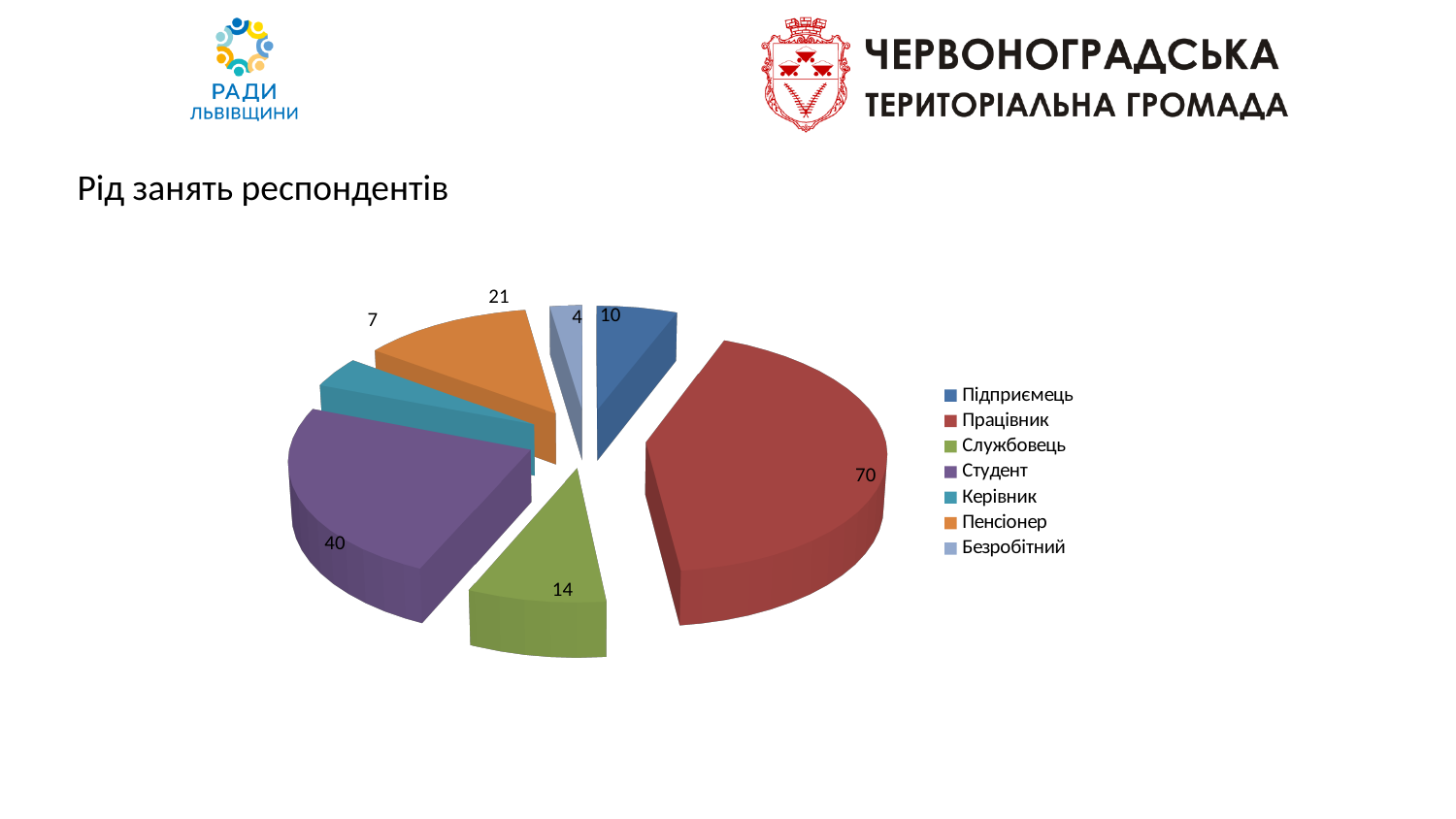
Which is larger, the value for Службовець or the value for Підприємець? Службовець What type of chart is shown on the slide? pie chart What is the value for Студент? 40 What colour is the slice for Пенсіонер? orange What is the value for Працівник? 70 What is the value for Пенсіонер? 21 What is the value for Керівник? 7 What is the difference between the values for Працівник and Студент? 30 How many categories does the legend list? 7 Which category has the largest slice? Працівник Which category has the smallest slice? Безробітний What is the title of the chart? Рід занять респондентів